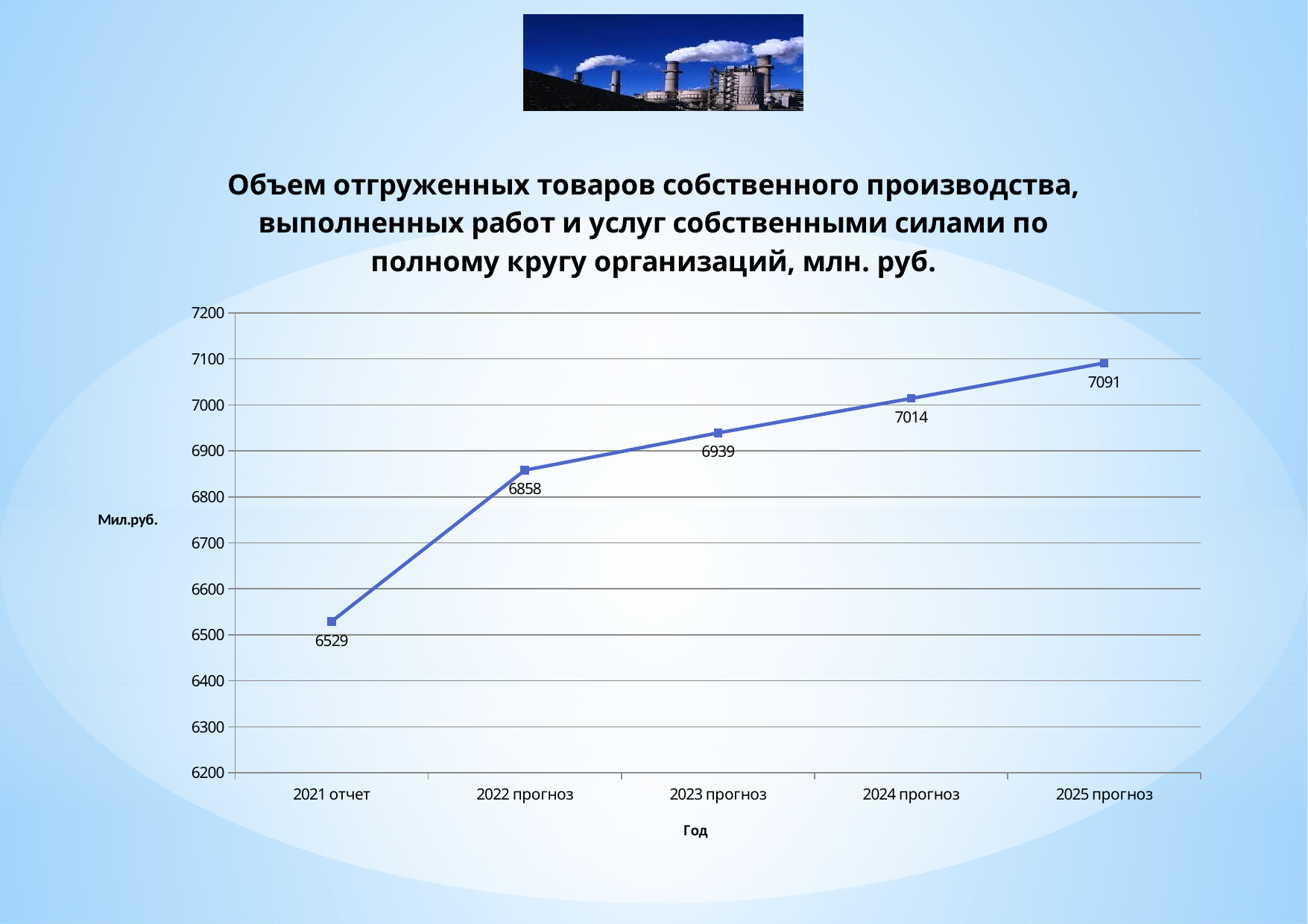
Which year has the lowest value? 2021 отчет Which year has the highest value? 2025 прогноз Do the values rise or fall from 2021 to 2025? rise What is the value for 2021 отчет? 6529 What is the difference between the values for 2025 прогноз and 2024 прогноз? 77 Is the value for 2022 прогноз greater or less than 6900? less What is the value for 2025 прогноз? 7091 What kind of chart is shown on the slide? line chart What is the value for 2023 прогноз? 6939 How many data points are plotted on the chart? 5 What is the difference between the values for 2022 прогноз and 2021 отчет? 329 Which is larger, the value for 2023 прогноз or the value for 2024 прогноз? 2024 прогноз